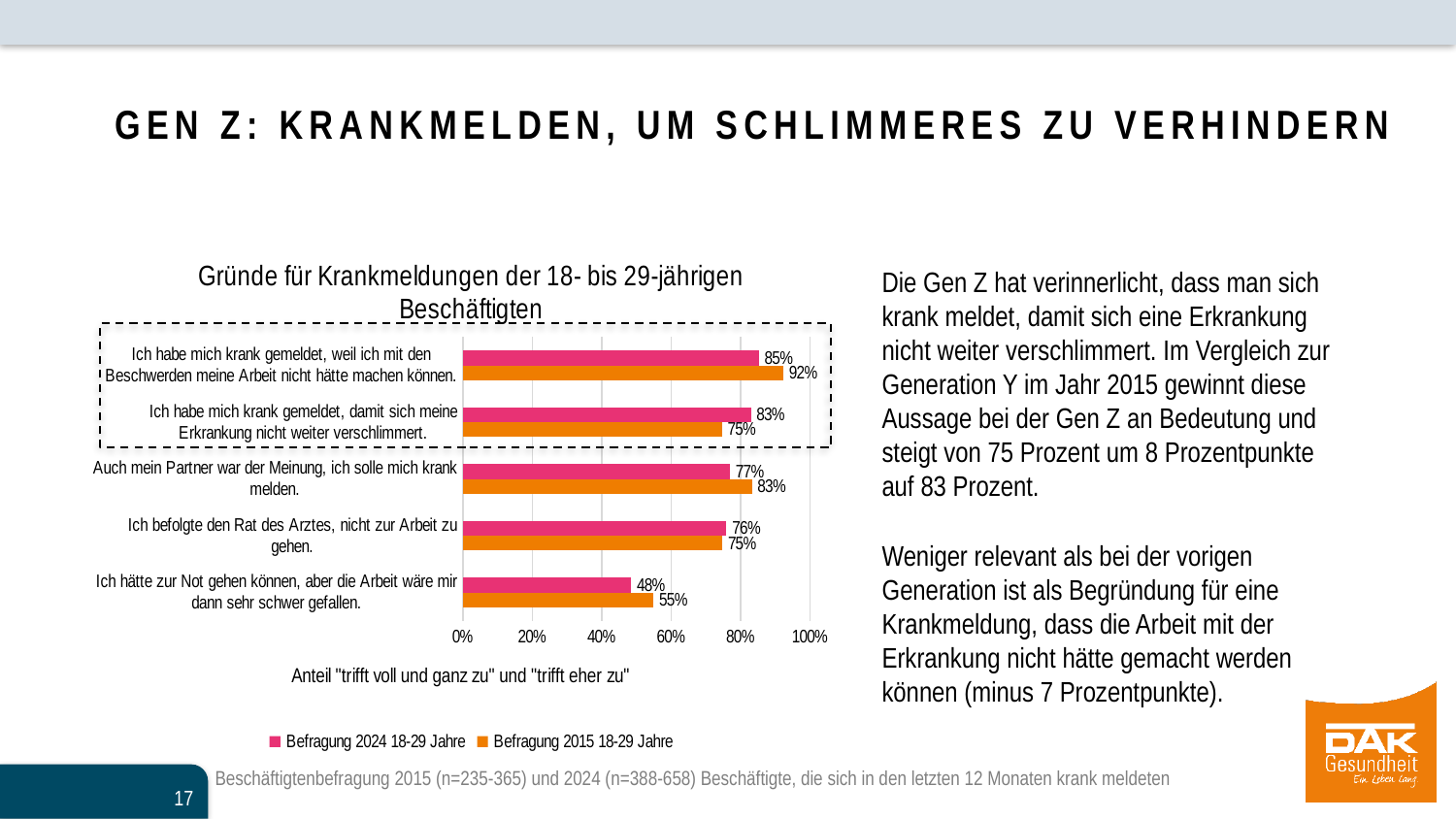
What is the value for 'Befragung 2024 18-29 Jahre' for 'Ich hätte zur Not gehen können, aber die Arbeit wäre mir dann sehr schwer gefallen.'? 48% How many series does the legend list? 2 What is the difference between the 2015 and 2024 values for 'Ich habe mich krank gemeldet, weil ich mit den Beschwerden meine Arbeit nicht hätte machen können.'? 7% What is the value for 'Befragung 2024 18-29 Jahre' for 'Ich habe mich krank gemeldet, damit sich meine Erkrankung nicht weiter verschlimmert.'? 83% How many categories (reasons) are shown in the chart? 5 Is the 2015 value for 'Ich hätte zur Not gehen können, aber die Arbeit wäre mir dann sehr schwer gefallen.' greater or less than 60%? less Which category has the lowest value for 'Befragung 2024 18-29 Jahre'? Ich hätte zur Not gehen können, aber die Arbeit wäre mir dann sehr schwer gefallen. What is the value for 'Befragung 2015 18-29 Jahre' for 'Ich habe mich krank gemeldet, weil ich mit den Beschwerden meine Arbeit nicht hätte machen können.'? 92% What type of chart is shown on the slide? bar chart For 'Auch mein Partner war der Meinung, ich solle mich krank melden.', which survey has the larger value, 2024 or 2015? Befragung 2015 18-29 Jahre What is the title of the chart? Gründe für Krankmeldungen der 18- bis 29-jährigen Beschäftigten Which category has the highest value for 'Befragung 2015 18-29 Jahre'? Ich habe mich krank gemeldet, weil ich mit den Beschwerden meine Arbeit nicht hätte machen können.